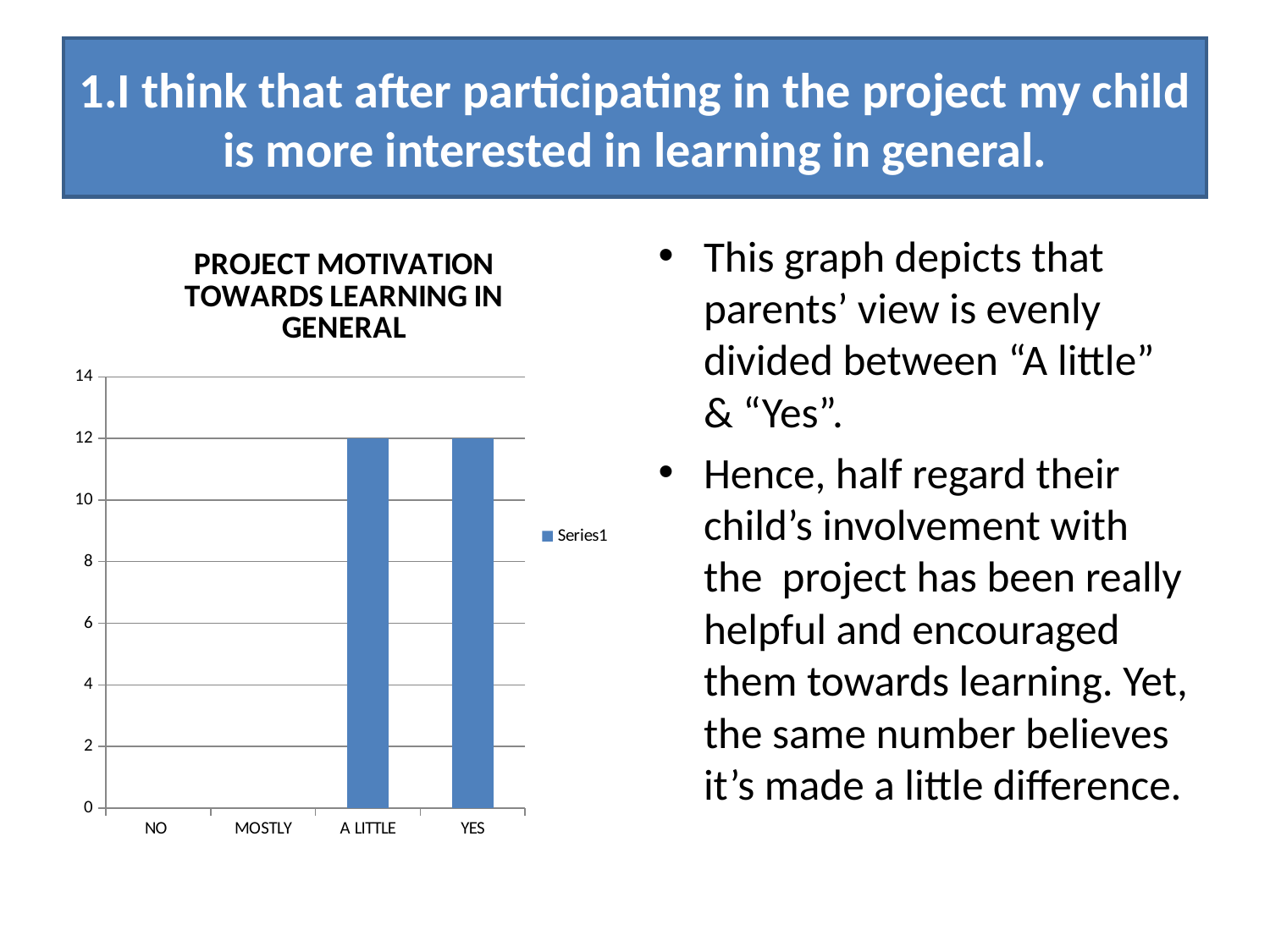
Which is larger, the value for YES or the value for NO? YES How many categories are shown on the x axis of the chart? 4 Is the value for A LITTLE greater or less than 10? greater How many series does the chart's legend list? 1 What is the name of the series shown in the chart's legend? Series1 What is the title of the chart? PROJECT MOTIVATION TOWARDS LEARNING IN GENERAL What is the value for YES in the chart? 12 What kind of chart is shown on the slide? bar chart What is the value for A LITTLE in the chart? 12